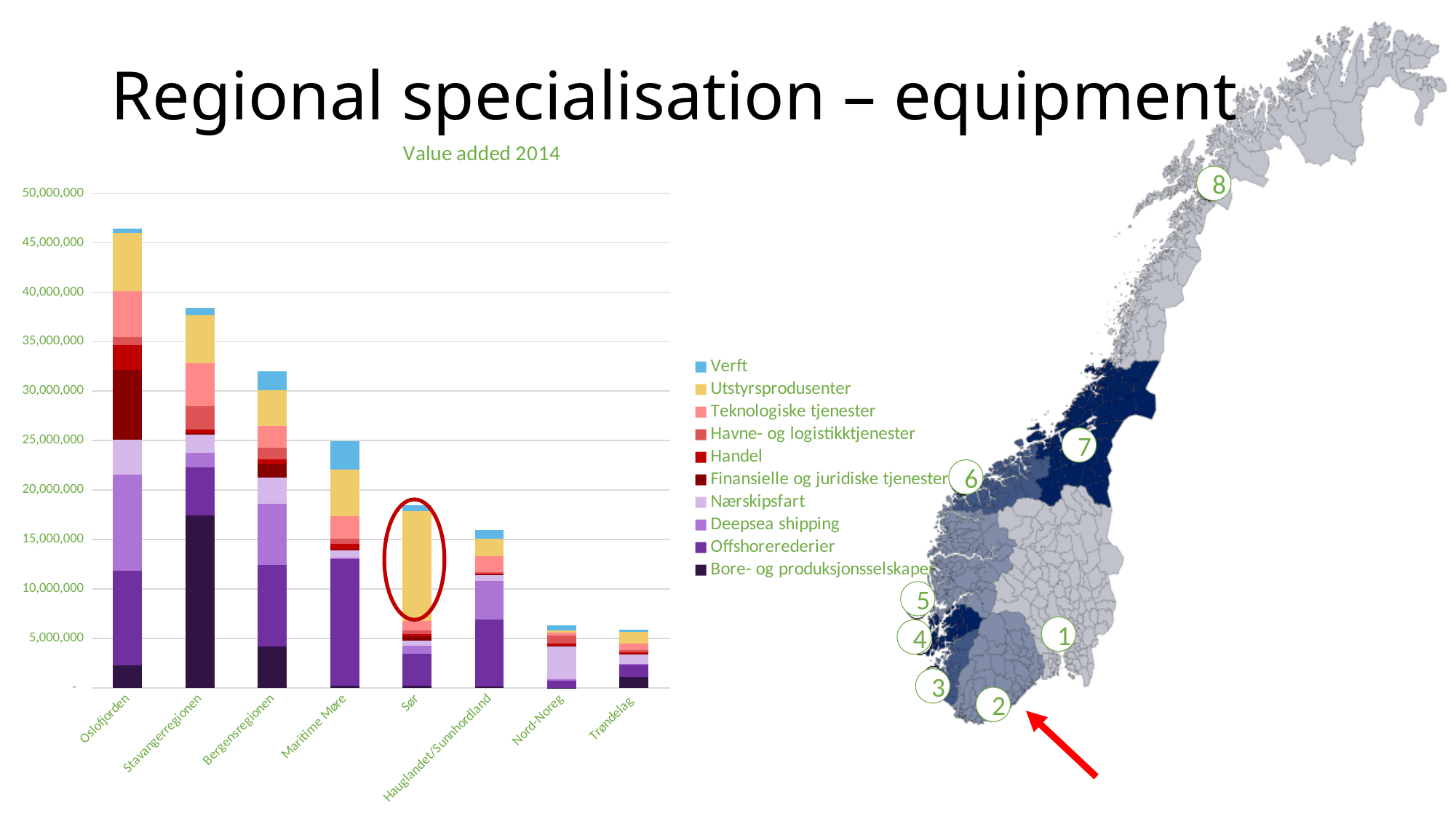
What kind of chart is shown on the slide? Stacked bar chart Is the total value for Sør greater or less than 20,000,000? less Which region has the larger total bar, Stavangerregionen or Sør? Stavangerregionen How many series does the chart legend list? 10 Which region's bar is circled in red on the chart? Sør Is the total value for Stavangerregionen greater or less than 35,000,000? greater Do the total bar heights generally rise or fall from left to right across the regions? fall Which region has the larger total bar, Bergensregionen or Maritime Møre? Bergensregionen Is the total value for Bergensregionen greater or less than 30,000,000? greater How many regions are shown on the x axis of the chart? 8 Which region has the highest total value added in the chart? Oslofjorden What is the title of the chart? Value added 2014